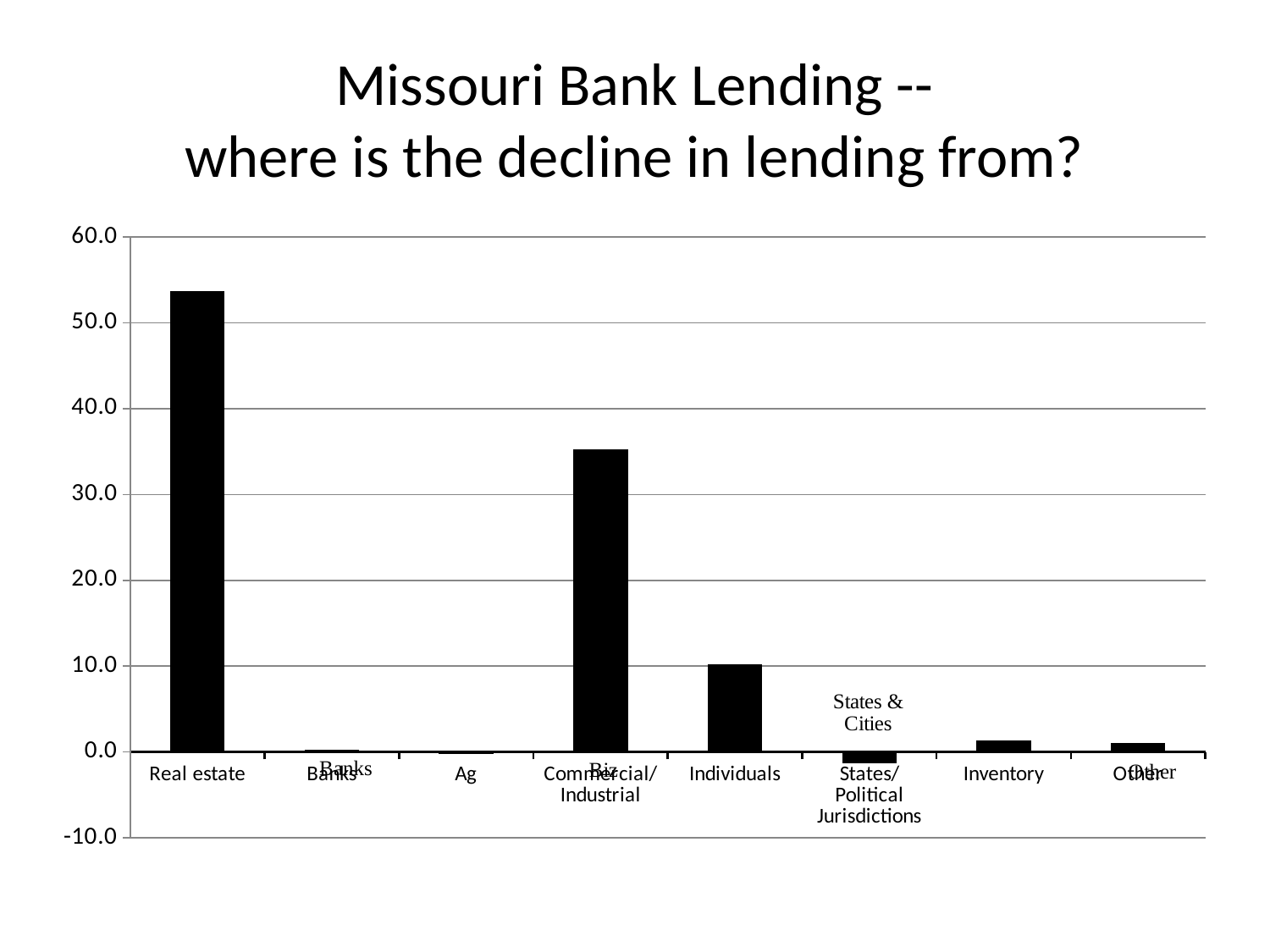
Is the value for Real estate greater or less than 50.0? greater What kind of chart is shown on the slide? bar chart Which is larger, the value for Individuals or the value for Inventory? Individuals What is the title of the slide? Missouri Bank Lending -- where is the decline in lending from? Which category has the highest value in the chart? Real estate Which is larger, the value for Real estate or the value for Commercial/Industrial? Real estate Is the value for Commercial/Industrial greater or less than 40.0? less Is the value for Inventory greater or less than 10.0? less How many categories are shown on the x axis of the chart? 8 Which category has the lowest value in the chart? States/Political Jurisdictions